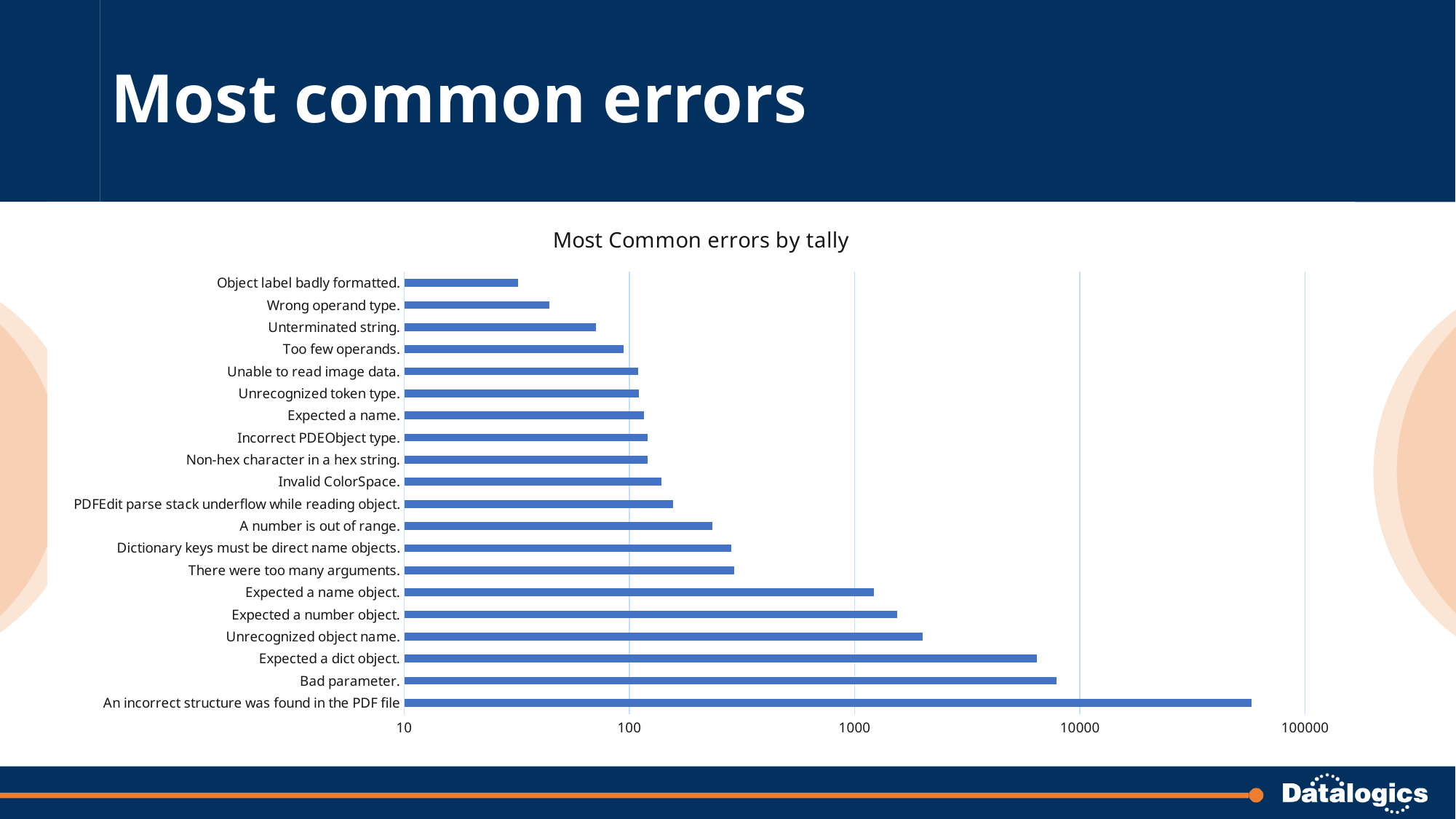
Which has the larger tally, "Expected a dict object." or "Unrecognized object name."? Expected a dict object. Is the value for "Object label badly formatted." greater or less than 100? less Is the value for "Bad parameter." greater or less than 10000? less How many error categories are plotted in the chart? 20 Is the value for "A number is out of range." greater or less than 100? greater Which error has the highest tally? An incorrect structure was found in the PDF file Which error has the lowest tally? Object label badly formatted. Which has the larger tally, "Wrong operand type." or "Unterminated string."? Unterminated string. What is the title of the chart? Most Common errors by tally What kind of chart is shown on the slide? Bar chart